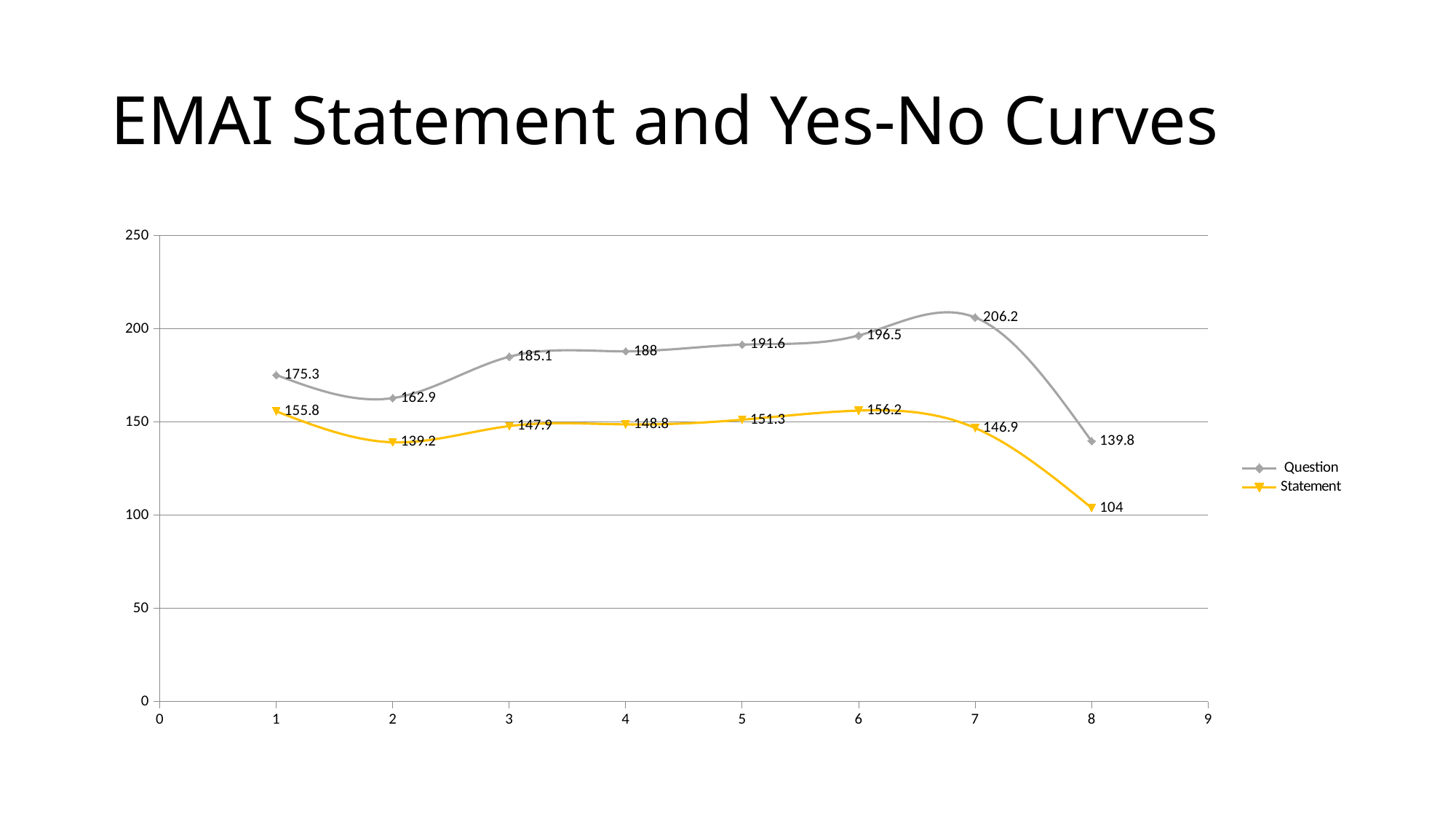
What is the difference between the Question and Statement values at x = 1? 19.5 Which series has the larger value at x = 4, Question or Statement? Question At which x value does the Statement series reach its lowest value? 8 What colour is the Statement series line? Yellow How many data points does the Statement series have? 8 What is the value of the Question series at x = 7? 206.2 What is the value of the Statement series at x = 3? 147.9 How many series does the legend list? 2 What is the value of the Statement series at x = 8? 104 Does the Question series rise or fall between x = 7 and x = 8? Fall What kind of chart is shown on the slide? Line chart At which x value does the Question series reach its highest value? 7